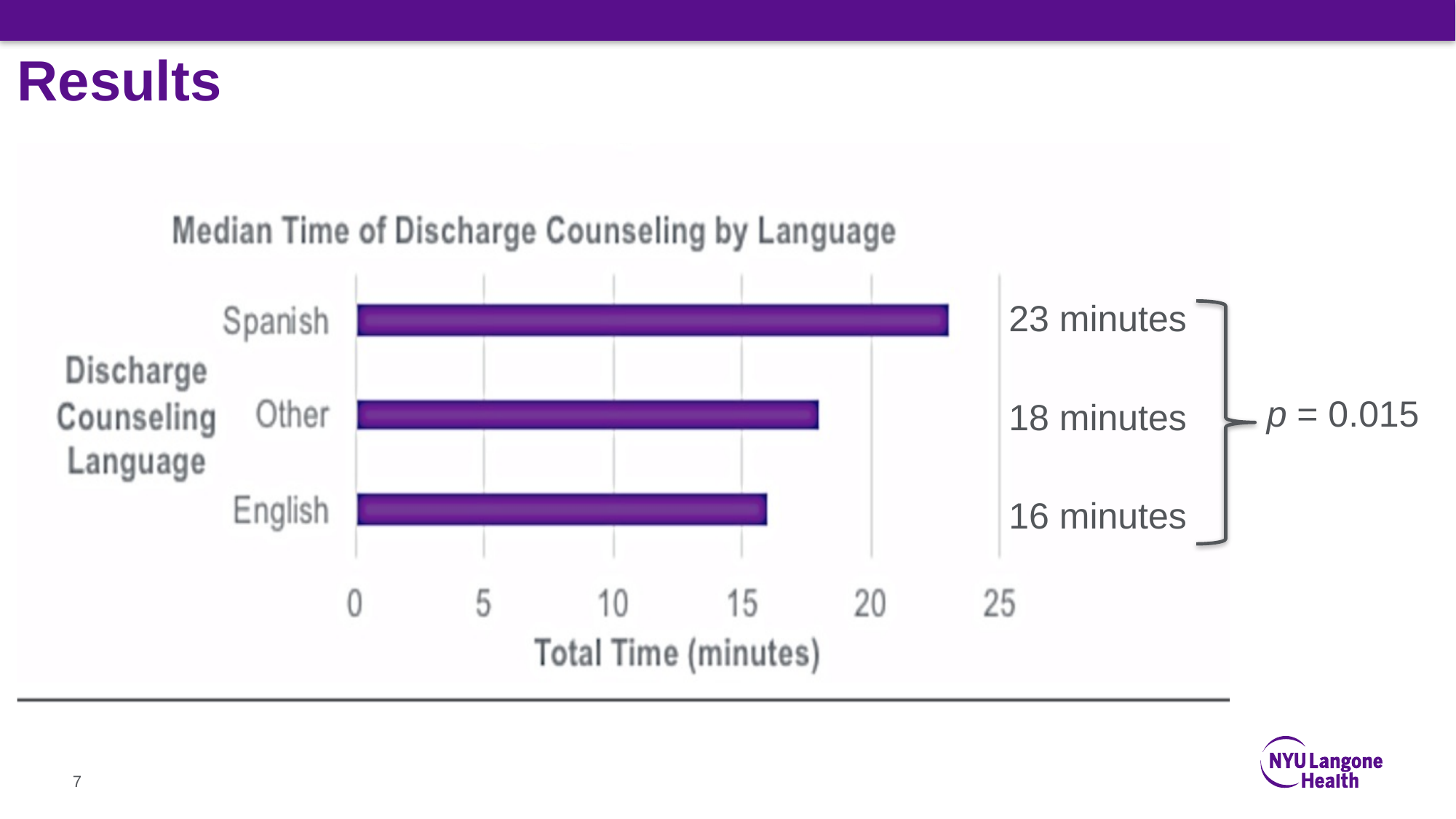
Is the median counseling time for Spanish greater or less than 20 minutes? greater What is the median discharge counseling time for Spanish? 23 minutes What kind of chart is shown on the slide? Bar chart What is the difference in median counseling time between Other and English? 2 minutes Which language has the highest median discharge counseling time? Spanish Which has a longer median counseling time, Spanish or Other? Spanish How many language categories are shown in the chart? 3 Which language has the lowest median discharge counseling time? English What is the median discharge counseling time for English? 16 minutes What is the median discharge counseling time for Other languages? 18 minutes How many minutes longer is the median counseling time for Spanish than for English? 7 minutes What is the title of the chart? Median Time of Discharge Counseling by Language